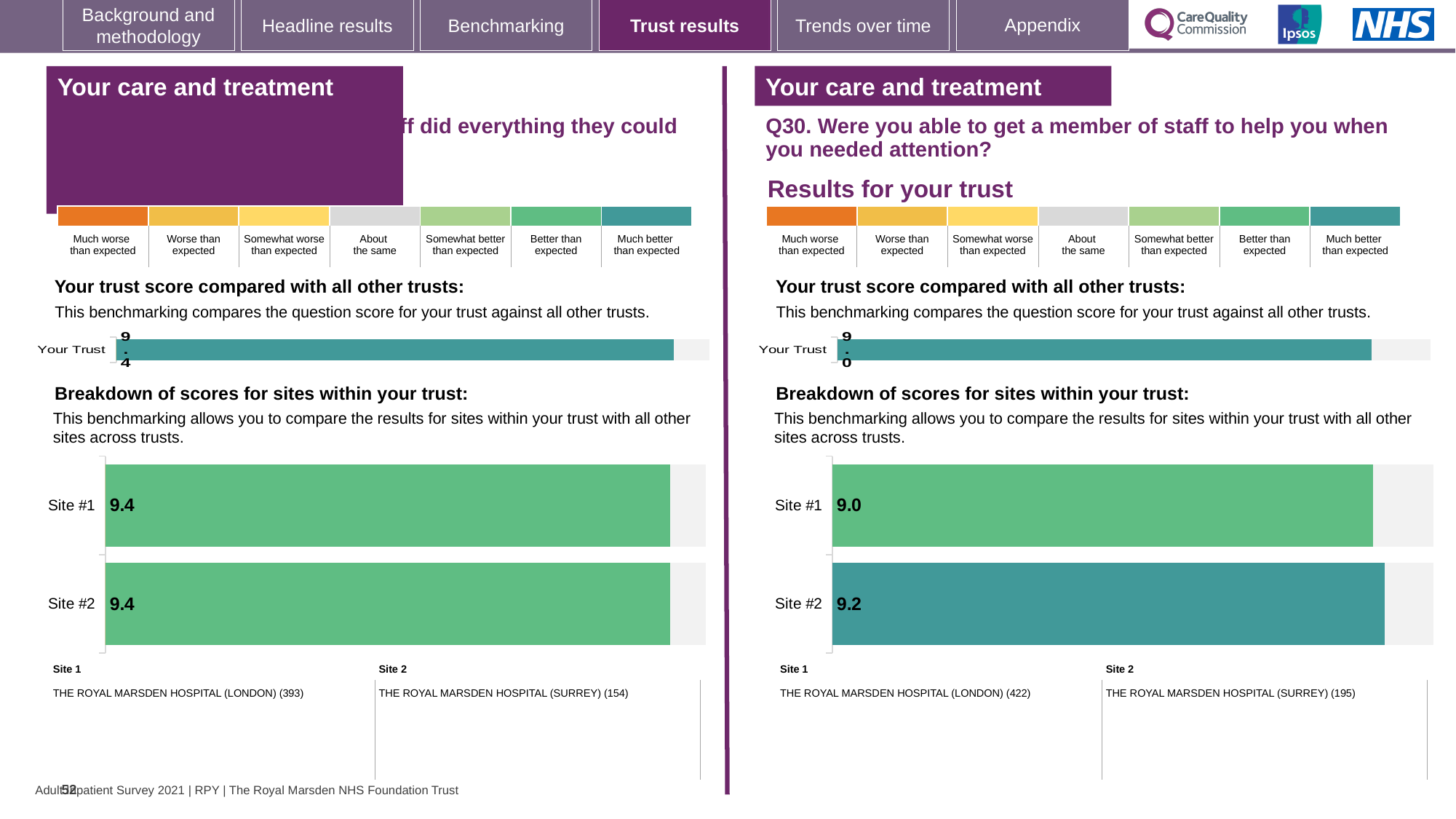
Which is larger: the Your Trust score on the left-hand chart or the Your Trust score on the right-hand (Q30) chart? The left-hand chart (9.4) On the right-hand (Q30) site breakdown chart, what is the difference between the Site #2 and Site #1 scores? 0.2 On the left-hand 'Breakdown of scores for sites within your trust' chart, what is the score for Site #2? 9.4 What type of chart is used for the site breakdown on the right-hand (Q30) side of the slide? Bar chart On the left-hand site breakdown chart, how many sites are plotted? 2 On the left-hand 'Your trust score compared with all other trusts' chart, what is the score shown for Your Trust? 9.4 On the right-hand (Q30) 'Breakdown of scores for sites within your trust' chart, what is the score for Site #2? 9.2 On the right-hand (Q30) site breakdown chart, which site's bar is coloured teal rather than green? Site #2 On the right-hand (Q30) 'Breakdown of scores for sites within your trust' chart, what is the score for Site #1? 9.0 On the left-hand 'Breakdown of scores for sites within your trust' chart, what is the score for Site #1? 9.4 On the right-hand (Q30) 'Your trust score compared with all other trusts' chart, what is the score shown for Your Trust? 9.0 On the right-hand (Q30) site breakdown chart, which site has the higher score? Site #2